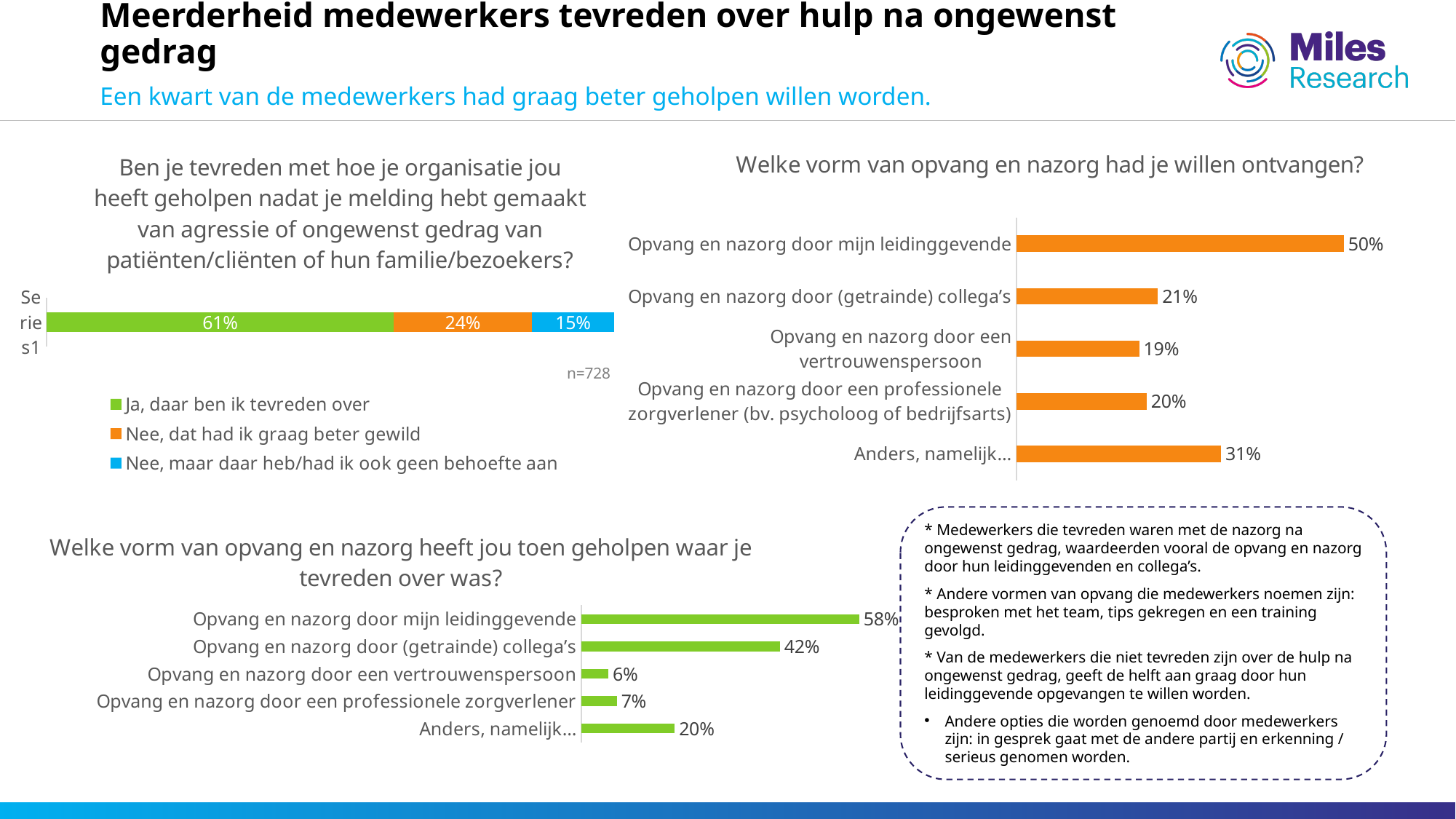
In the bottom-left chart 'Welke vorm van opvang en nazorg heeft jou toen geholpen waar je tevreden over was?', what is the difference between 'Opvang en nazorg door mijn leidinggevende' and 'Opvang en nazorg door (getrainde) collega's'? 16% In the top-right chart 'Welke vorm van opvang en nazorg had je willen ontvangen?', what is the difference between 'Opvang en nazorg door mijn leidinggevende' and 'Anders, namelijk…'? 19% In the bottom-left chart 'Welke vorm van opvang en nazorg heeft jou toen geholpen waar je tevreden over was?', which category has the highest value? Opvang en nazorg door mijn leidinggevende In the top-left stacked bar chart, what is the total of the three segments? 100% In the bottom-left chart 'Welke vorm van opvang en nazorg heeft jou toen geholpen waar je tevreden over was?', what is the value for 'Opvang en nazorg door (getrainde) collega's'? 42% In the top-right chart 'Welke vorm van opvang en nazorg had je willen ontvangen?', which category has the lowest value? Opvang en nazorg door een vertrouwenspersoon In the top-right chart 'Welke vorm van opvang en nazorg had je willen ontvangen?', how many categories are shown? 5 In the top-left stacked bar chart, what is the value for 'Ja, daar ben ik tevreden over'? 61% In the bottom-left chart 'Welke vorm van opvang en nazorg heeft jou toen geholpen waar je tevreden over was?', which is larger: 'Opvang en nazorg door een vertrouwenspersoon' or 'Anders, namelijk…'? Anders, namelijk… What type of chart is the top-right chart 'Welke vorm van opvang en nazorg had je willen ontvangen?'? Bar chart How many entries does the legend of the top-left stacked bar chart list? 3 In the top-right chart 'Welke vorm van opvang en nazorg had je willen ontvangen?', what is the value for 'Opvang en nazorg door mijn leidinggevende'? 50%